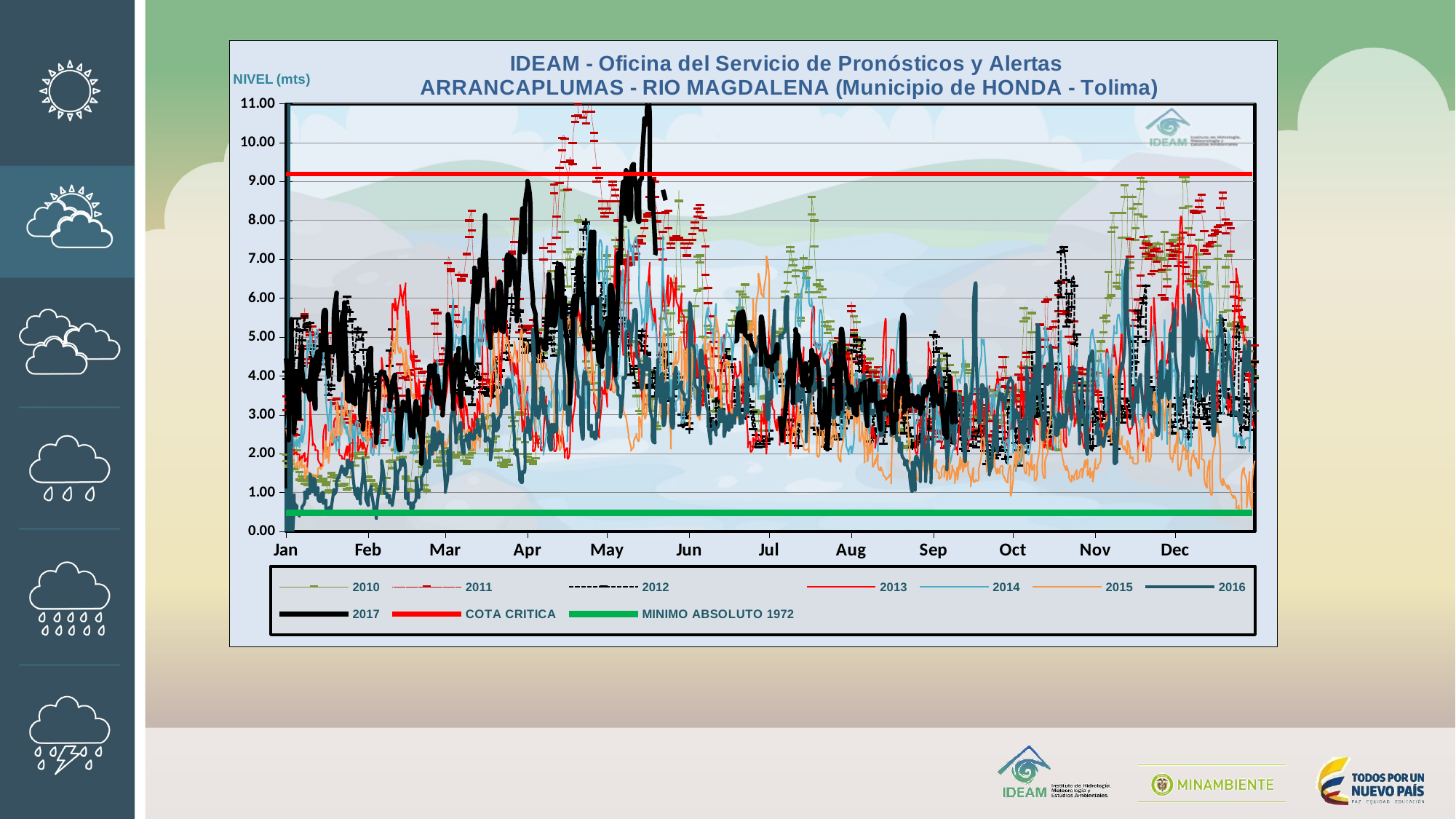
What is the lowest value shown on the vertical axis? 0.00 What is the title of the chart? IDEAM - Oficina del Servicio de Pronósticos y Alertas ARRANCAPLUMAS - RIO MAGDALENA (Municipio de HONDA - Tolima) Which of the two horizontal reference lines is higher, COTA CRITICA or MINIMO ABSOLUTO 1972? COTA CRITICA How many series does the legend list? 10 Is the value of the MINIMO ABSOLUTO 1972 line greater or less than 1.00? less Is the peak of the 2017 series in May greater or less than 10.00? greater Is the value of the COTA CRITICA line greater or less than 9.00? greater What is the highest value shown on the vertical axis? 11.00 Which month label appears first on the x axis? Jan What label is given to the vertical axis of the chart? NIVEL (mts) How many months are labelled along the x axis? 12 What kind of chart is shown on the slide? line chart